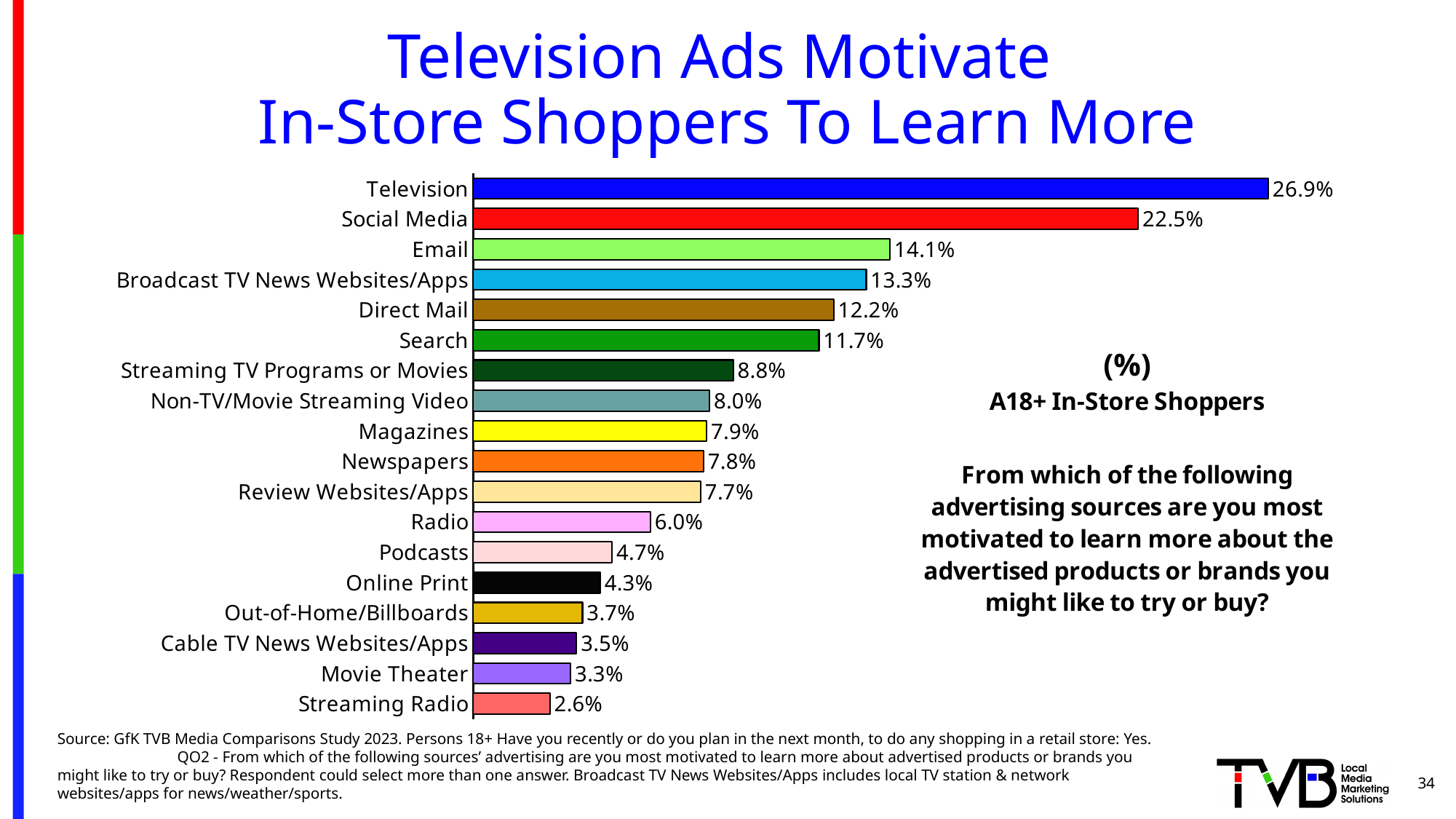
What kind of chart is shown on the slide? Bar chart What is the value shown for Podcasts? 4.7% What percentage of A18+ in-store shoppers are most motivated by Television ads to learn more? 26.9% Which advertising source has the highest value on the chart? Television What is the value shown for Direct Mail? 12.2% What is the difference between the values for Email and Broadcast TV News Websites/Apps? 0.8% Which has a larger value, Radio or Online Print? Radio What is the difference between the values for Television and Social Media? 4.4% What colour is the bar for Social Media? Red Which has a larger value, Search or Streaming TV Programs or Movies? Search Which advertising source has the lowest value on the chart? Streaming Radio How many advertising sources are listed on the chart? 18